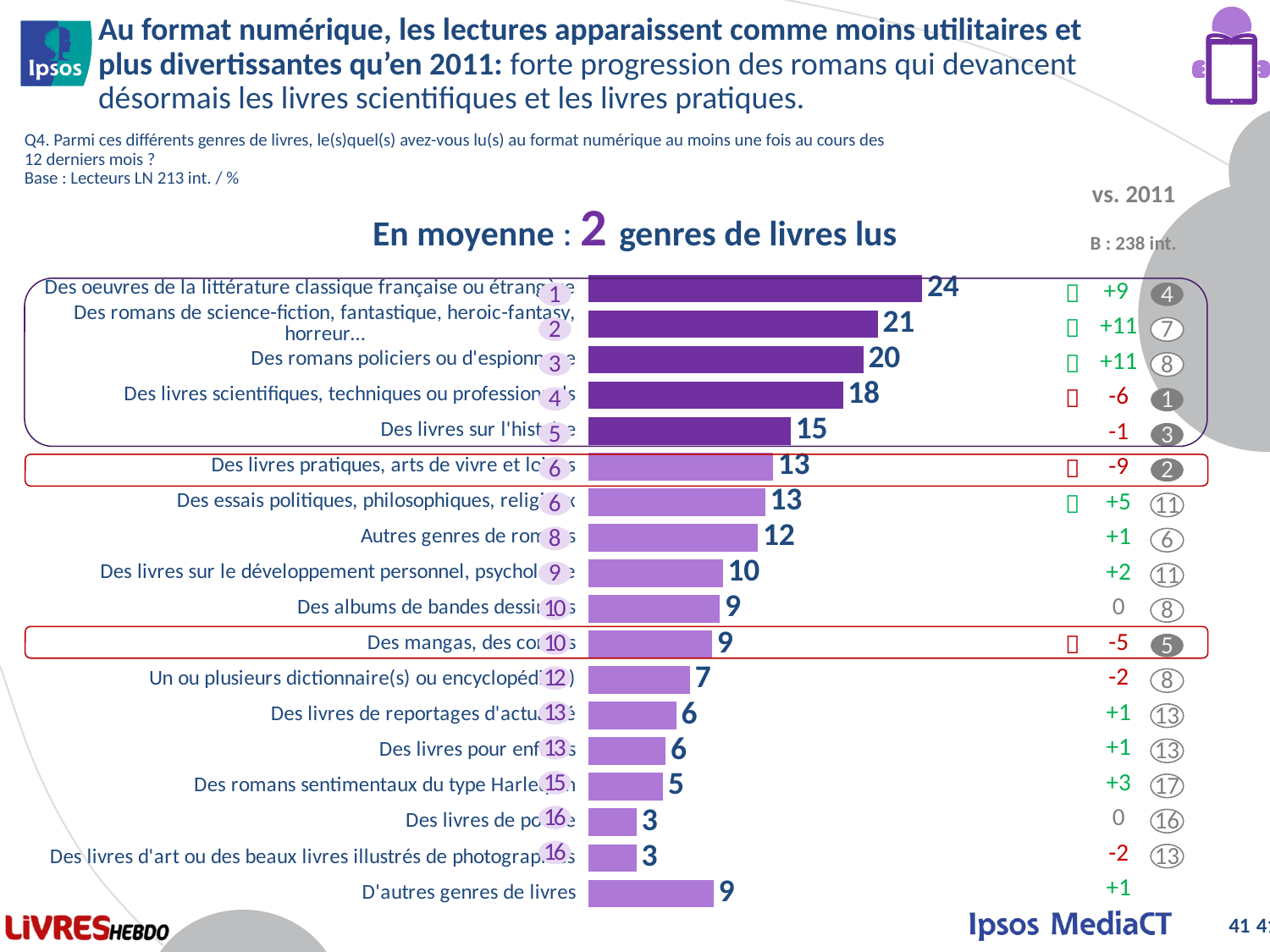
What is the value for 'D'autres genres de livres'? 9 According to the chart heading, how many genres of books are read on average? 2 What is the value for 'Des romans de science-fiction, fantastique, heroic-fantasy, horreur…'? 21 What is the difference between the value for 'Des oeuvres de la littérature classique française ou étrangère' and 'Des romans de science-fiction, fantastique, heroic-fantasy, horreur…'? 3 Which has a larger value: 'Des livres sur l'histoire' or 'Autres genres de romans'? Des livres sur l'histoire What is the lowest value shown in the bar chart? 3 What kind of chart is shown on the slide? bar chart What is the value for 'Des livres scientifiques, techniques ou professionnels'? 18 What is the value for 'Des livres pour enfants'? 6 Which genre has the highest value in the bar chart? Des oeuvres de la littérature classique française ou étrangère How many categories (genres of books) are plotted in the bar chart? 18 What is the difference between the value for 'Des livres scientifiques, techniques ou professionnels' and 'Des livres pratiques, arts de vivre et loisirs'? 5